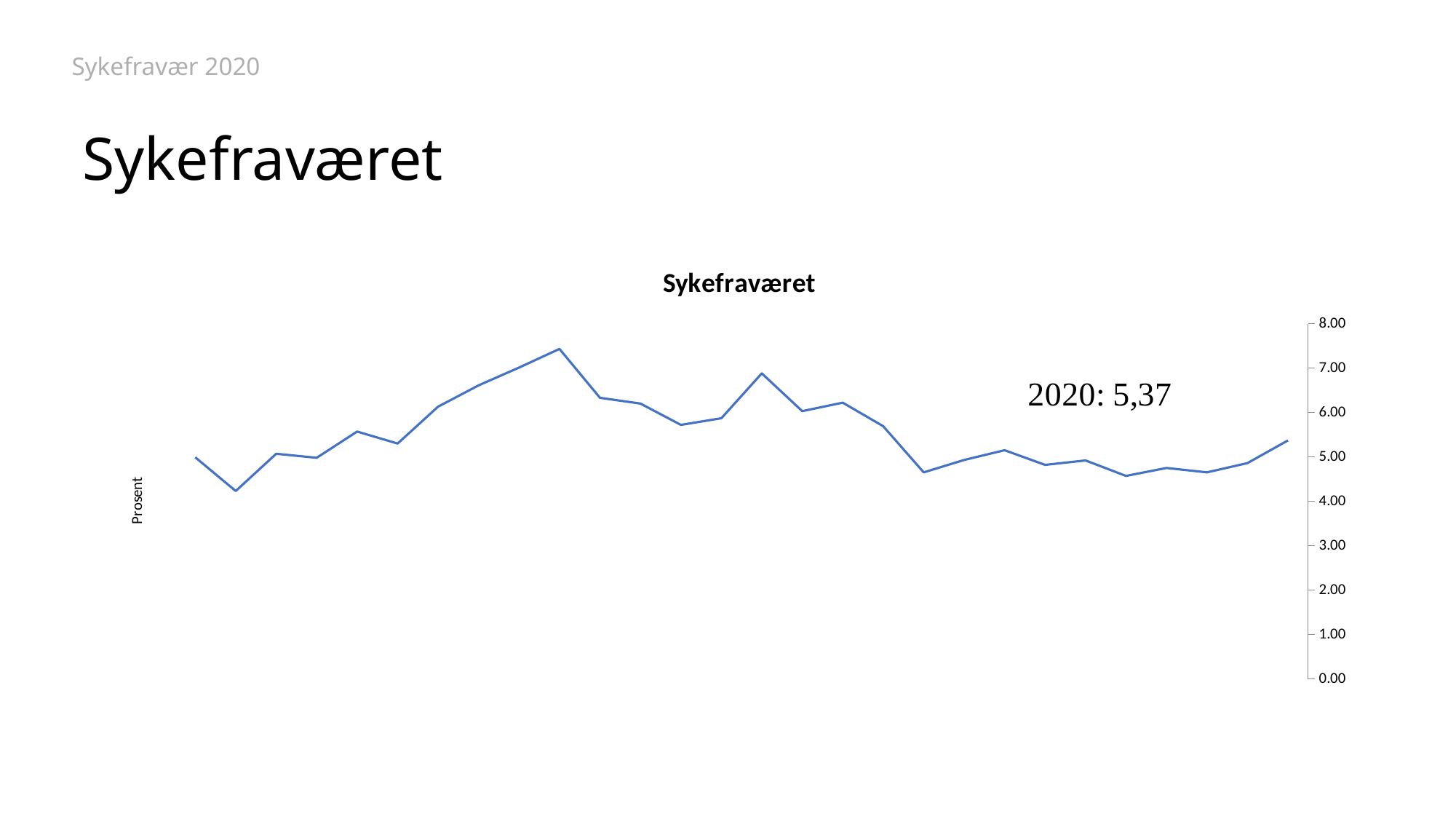
What is the title of the chart? Sykefraværet Is the lowest point on the line greater or less than 5.00? less What kind of chart is shown on the slide? line chart Is the highest peak of the line larger than the value annotated for 2020 (5,37)? yes What is the label on the vertical axis of the chart? Prosent Does the line rise or fall immediately after reaching its highest peak? fall Is the last point on the line greater or less than 5.00? greater What value is annotated for 2020 on the chart? 5,37 Is the first point on the line greater or less than 6.00? less Does the line rise or fall between its last two points? rise